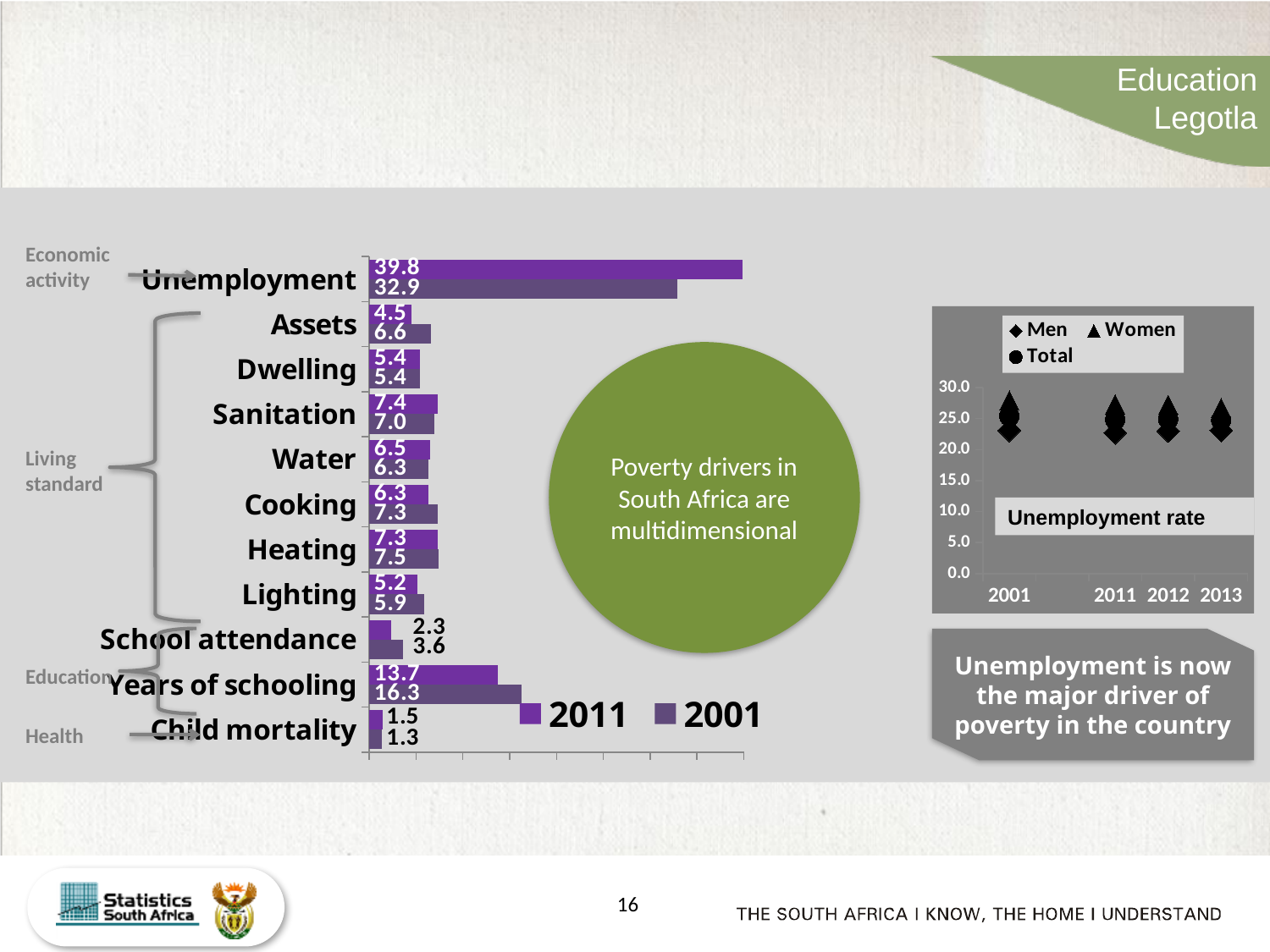
In the bar chart on the left, which category has the lowest 2001 value? Child mortality In the bar chart on the left, which is larger for Cooking: the 2011 value or the 2001 value? 2001 In the bar chart on the left, what is the difference between the 2011 and 2001 values for Unemployment? 6.9 In the bar chart on the left, which category has the highest 2011 value? Unemployment How many series does the legend of the bar chart on the left list? 2 In the bar chart on the left, what is the 2011 value for Unemployment? 39.8 What kind of chart is the chart on the left of the slide? Bar chart In the bar chart on the left, what is the 2001 value for Years of schooling? 16.3 How many categories are shown in the bar chart on the left? 11 How many years are shown on the x axis of the Unemployment rate chart on the right? 4 In the Unemployment rate chart on the right, is the Total value for 2001 greater or less than 20.0? greater In the Unemployment rate chart on the right, how many series does the legend list? 3